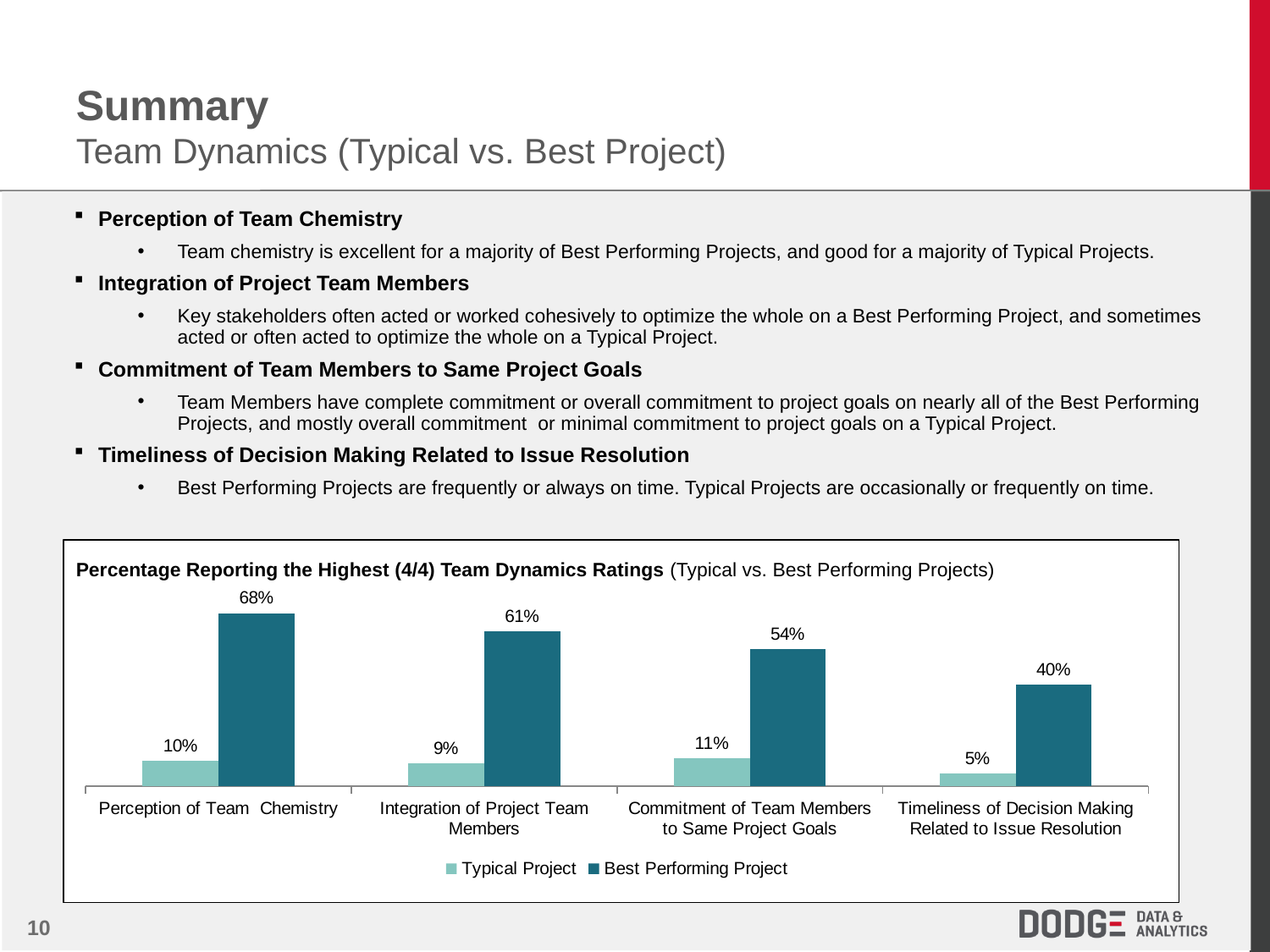
What is the value for Best Performing Project for Perception of Team Chemistry? 68% How many series does the legend list? 2 Which is larger: the Typical Project value for Perception of Team Chemistry or the Typical Project value for Integration of Project Team Members? Perception of Team Chemistry Which category has the highest Best Performing Project value? Perception of Team Chemistry What are the two series named in the legend? Typical Project and Best Performing Project Which category has the lowest Typical Project value? Timeliness of Decision Making Related to Issue Resolution What kind of chart is shown on the slide? Bar chart What is the value for Typical Project for Timeliness of Decision Making Related to Issue Resolution? 5% What is the difference between the Best Performing Project and Typical Project values for Integration of Project Team Members? 52% How many categories are shown on the x axis? 4 What is the value for Typical Project for Commitment of Team Members to Same Project Goals? 11% Do the Best Performing Project values rise or fall from left to right across the categories? Fall